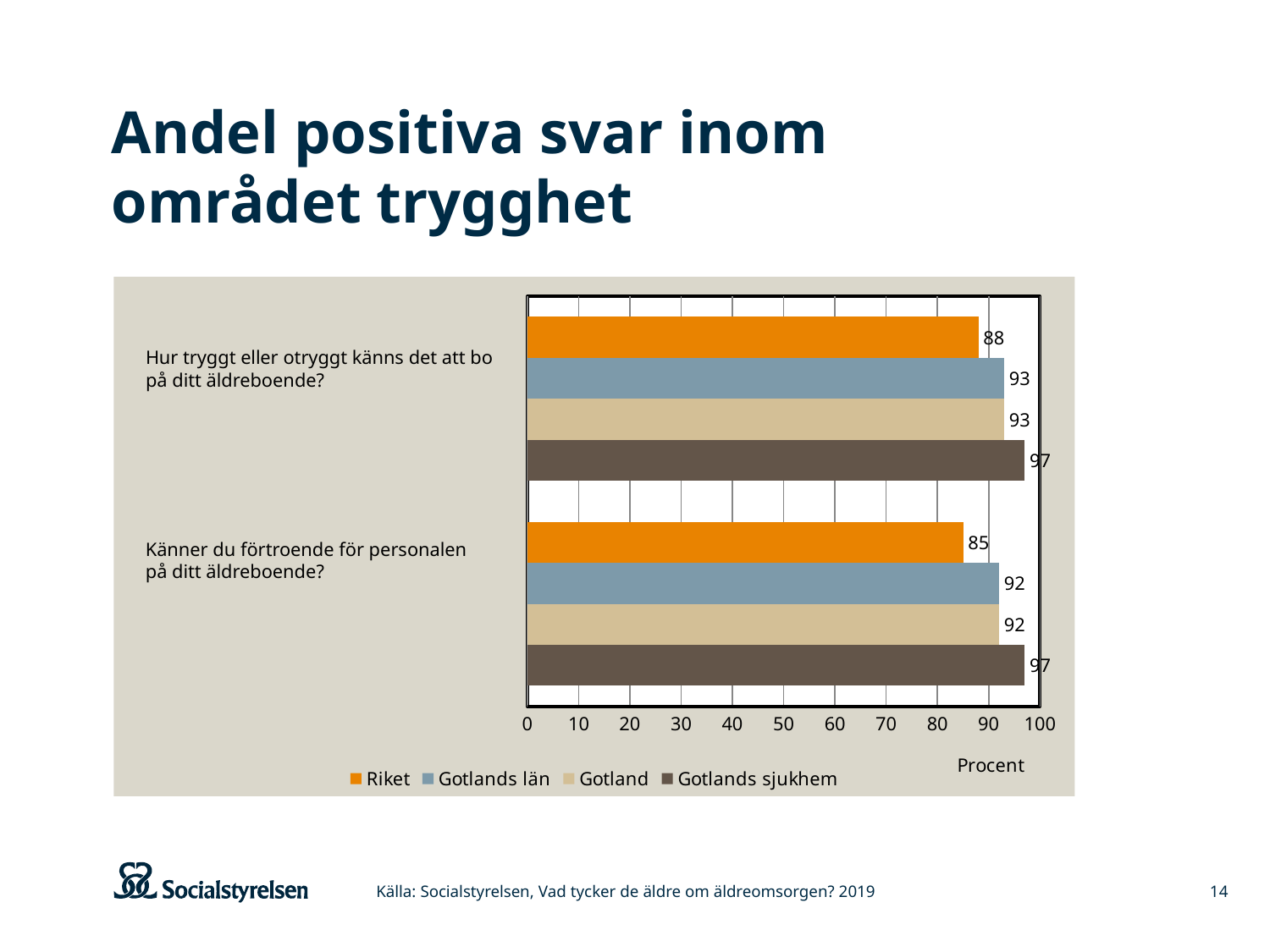
Which series has the highest value on the question "Hur tryggt eller otryggt känns det att bo på ditt äldreboende?"? Gotlands sjukhem What kind of chart is shown on the slide? Bar chart What is the value for Gotlands län on the question "Känner du förtroende för personalen på ditt äldreboende?"? 92 Which series has the lowest value on the question "Känner du förtroende för personalen på ditt äldreboende?"? Riket What is the value for Gotland on the question "Hur tryggt eller otryggt känns det att bo på ditt äldreboende?"? 93 What is the difference between Gotlands sjukhem and Riket on the question "Känner du förtroende för personalen på ditt äldreboende?"? 12 Which is larger on the question "Hur tryggt eller otryggt känns det att bo på ditt äldreboende?": Riket or Gotlands län? Gotlands län What is the unit label shown on the x axis? Procent What is the value for Gotlands sjukhem on the question "Känner du förtroende för personalen på ditt äldreboende?"? 97 Is the value for Riket on the question "Känner du förtroende för personalen på ditt äldreboende?" greater or less than 90? less How many series does the legend list? 4 What is the value for Riket on the question "Hur tryggt eller otryggt känns det att bo på ditt äldreboende?"? 88